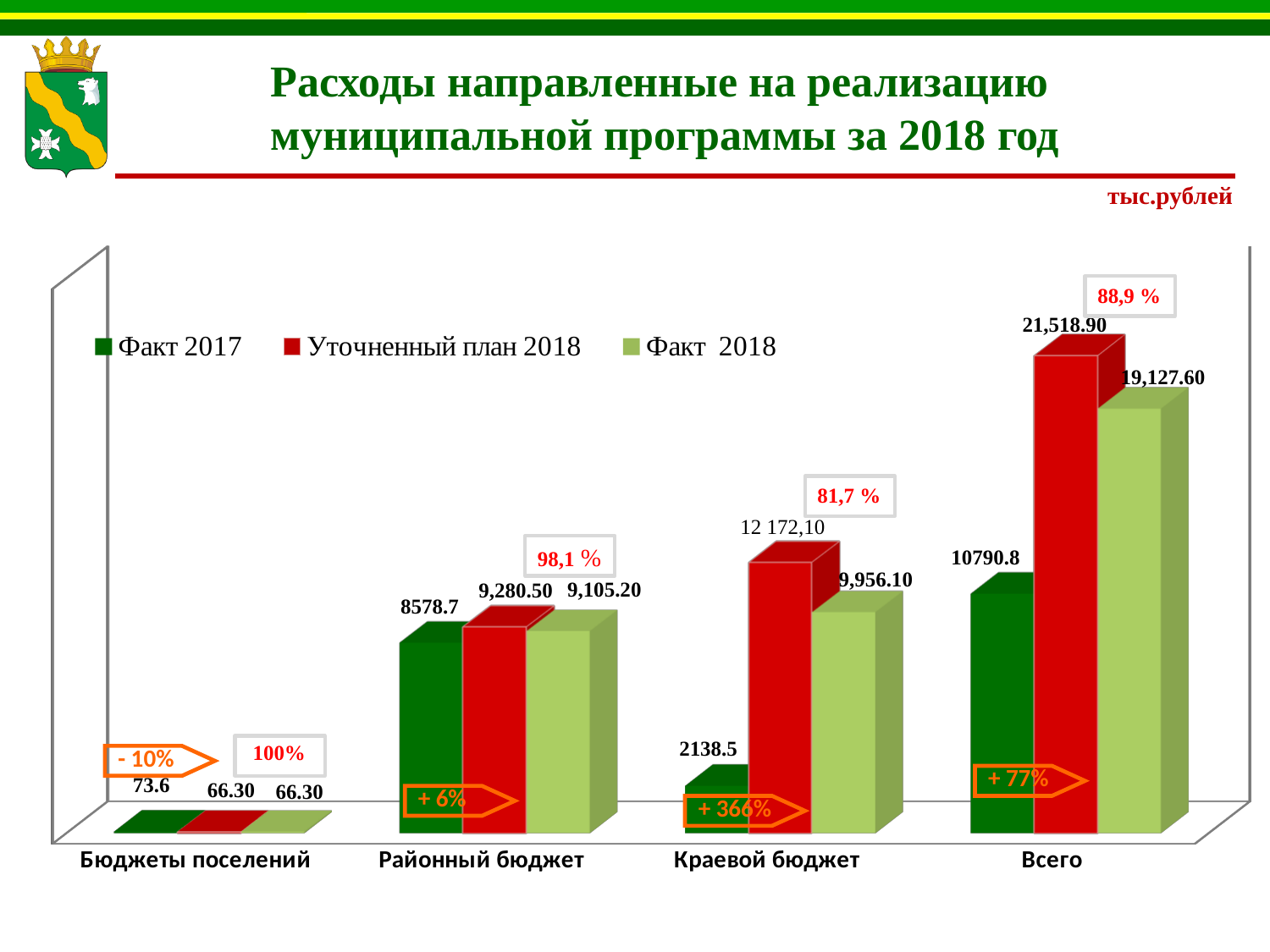
What unit of measurement is stated above the chart? тыс.рублей What is the value of Факт 2017 for Бюджеты поселений? 73.6 How many series does the legend list? 3 Which is larger for Краевой бюджет: Факт 2017 or Факт 2018? Факт 2018 What is the value of Факт 2017 for Районный бюджет? 8578.7 What type of chart is shown on the slide? bar chart What is the value of Факт 2018 for Краевой бюджет? 9,956.10 What is the difference between Уточненный план 2018 and Факт 2018 for Районный бюджет? 175.30 What is the value of Уточненный план 2018 for Всего? 21,518.90 Which category has the lowest value for Факт 2018? Бюджеты поселений How many categories are shown on the x axis? 4 Which category has the highest value for Уточненный план 2018? Всего